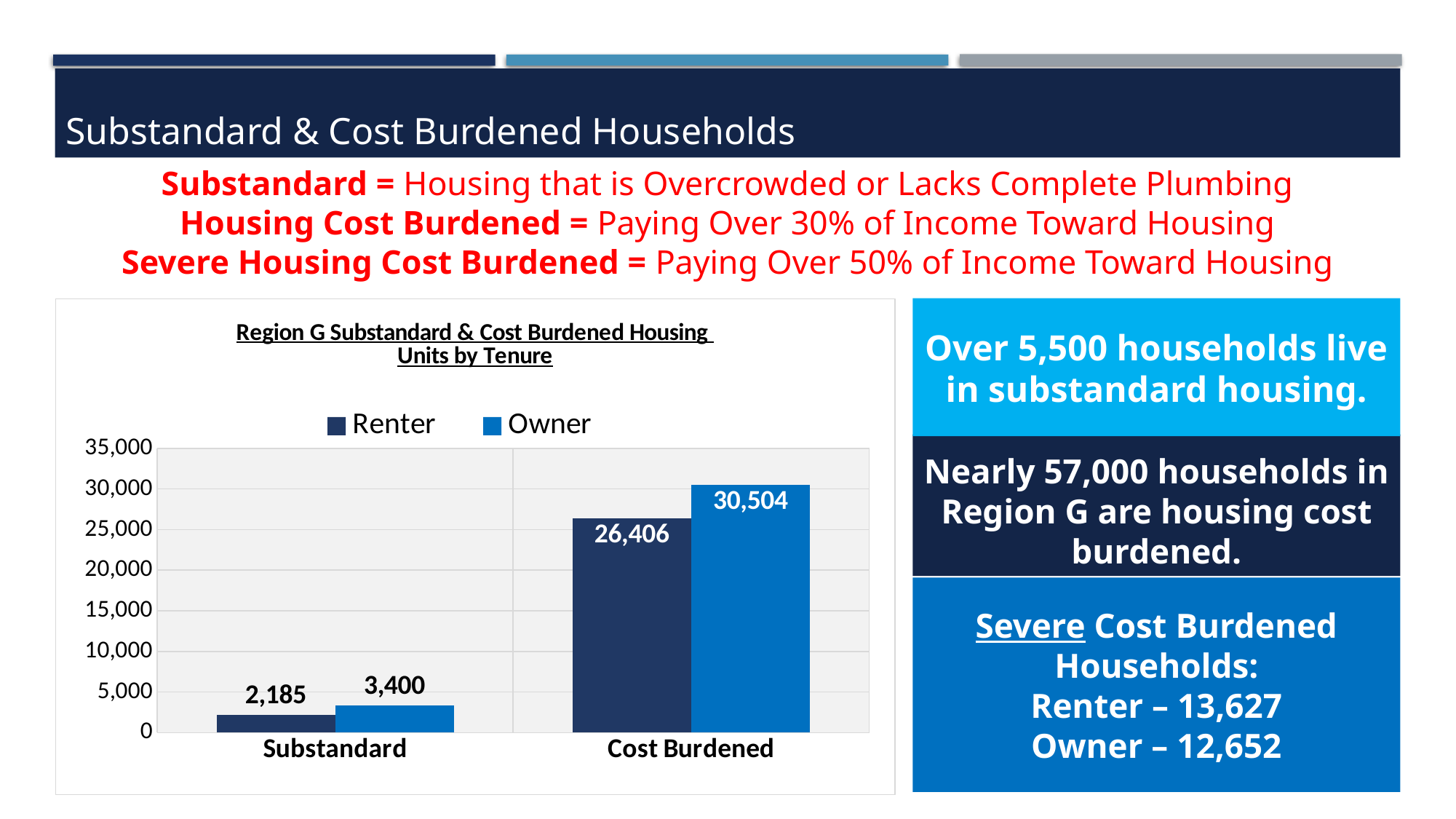
How many categories are shown on the x axis? 2 What is the Owner value for Substandard? 3,400 Which category has the highest Owner value? Cost Burdened How many series does the legend list? 2 What is the difference between the Owner and Renter values for Cost Burdened? 4,098 What is the difference between the Owner and Renter values for Substandard? 1,215 What is the Renter value for Substandard? 2,185 What is the Owner value for Cost Burdened? 30,504 For Cost Burdened, which is larger, the Renter value or the Owner value? Owner What kind of chart is shown on the slide? Bar chart What is the Renter value for Cost Burdened? 26,406 Which category has the lowest Renter value? Substandard